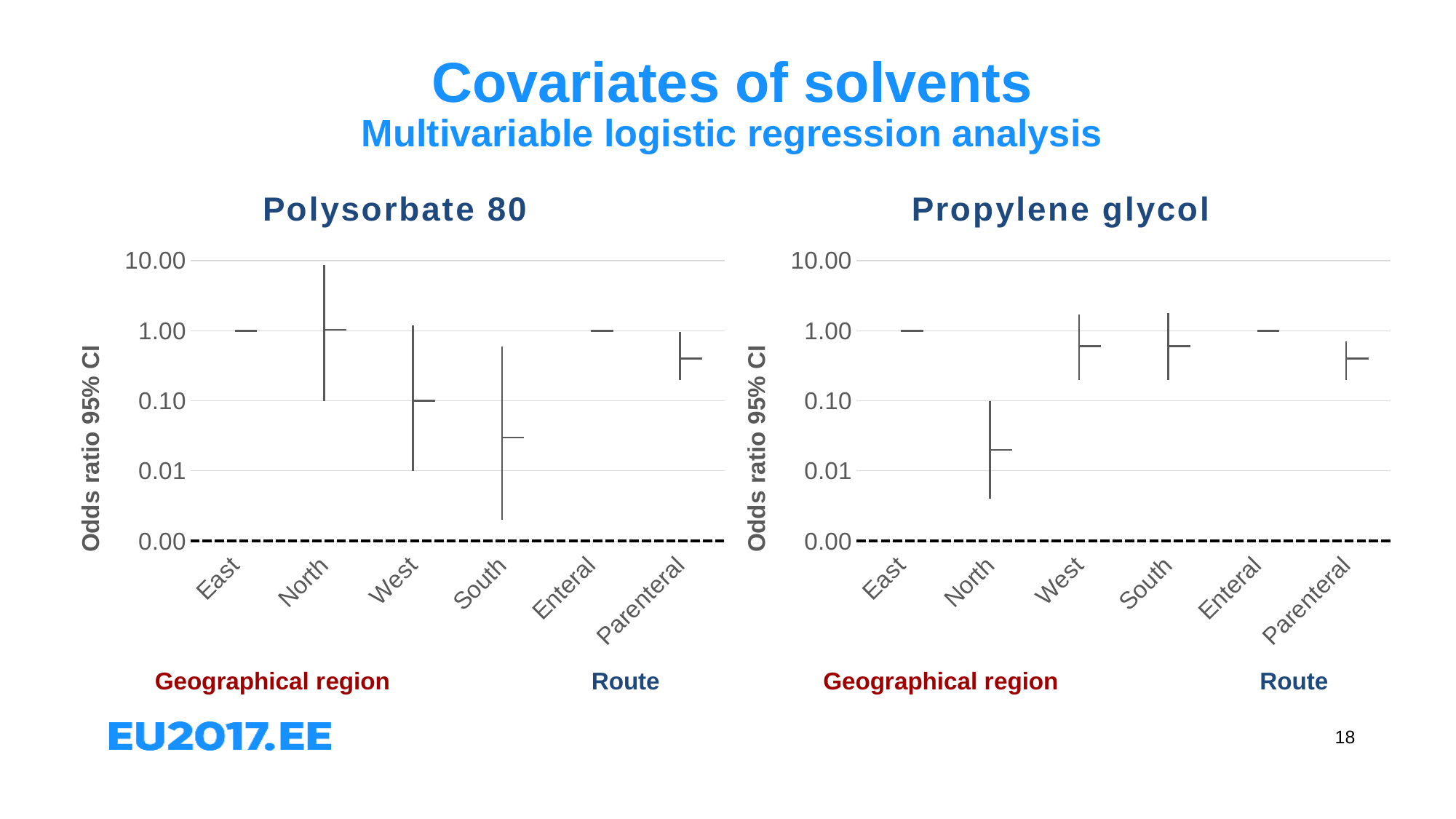
In the Propylene glycol chart, is the odds ratio for North greater or less than 0.10? less In the Polysorbate 80 chart, what is the odds ratio for East? 1.00 In the Propylene glycol chart, is the odds ratio for West greater or less than 1.00? less In the Polysorbate 80 chart, which has the higher odds ratio, North or South? North In the Propylene glycol chart, what is the odds ratio for Enteral? 1.00 In the Polysorbate 80 chart, how many categories are shown on the x axis? 6 In the Propylene glycol chart, what is the label of the y axis? Odds ratio 95% CI In the Polysorbate 80 chart, which category has the lowest odds ratio? South How many charts are on the slide, and what are their titles? Two: Polysorbate 80 and Propylene glycol In the Propylene glycol chart, which category has the lowest odds ratio? North In the Polysorbate 80 chart, is the odds ratio for South greater or less than 0.10? less